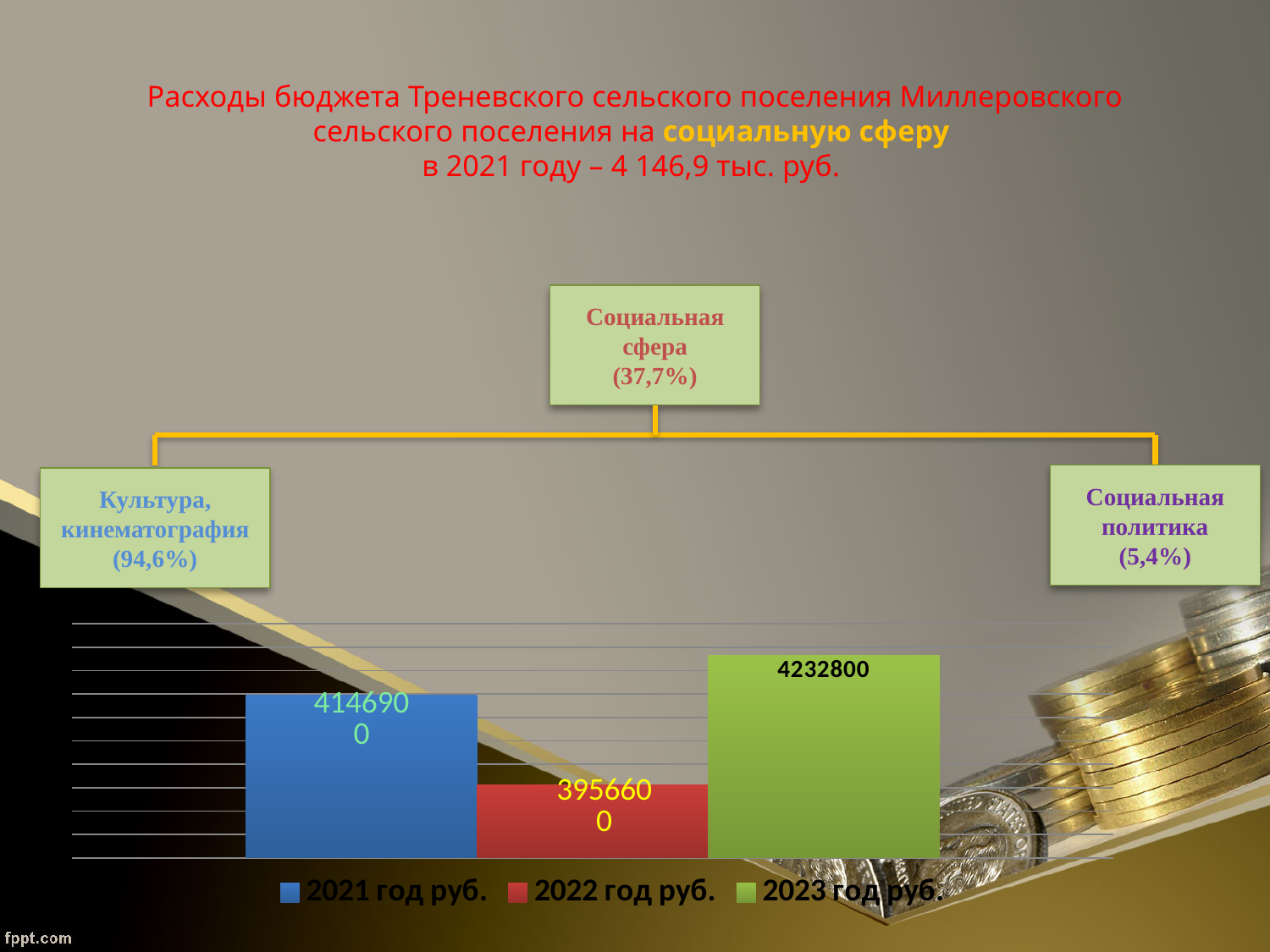
What is the value of the bar for 2023 год руб.? 4232800 Which year has the lowest bar in the chart? 2022 год руб. What is the difference between the 2023 год руб. value and the 2022 год руб. value? 276200 What colour is the bar for 2022 год руб.? red What is the value of the bar for 2021 год руб.? 4146900 What is the difference between the 2021 год руб. value and the 2022 год руб. value? 190300 How many bars are plotted in the chart? 3 Which is larger, the value for 2021 год руб. or the value for 2023 год руб.? 2023 год руб. What kind of chart is shown at the bottom of the slide? bar chart Which year has the highest bar in the chart? 2023 год руб. How many series does the chart legend list? 3 What is the value of the bar for 2022 год руб.? 3956600